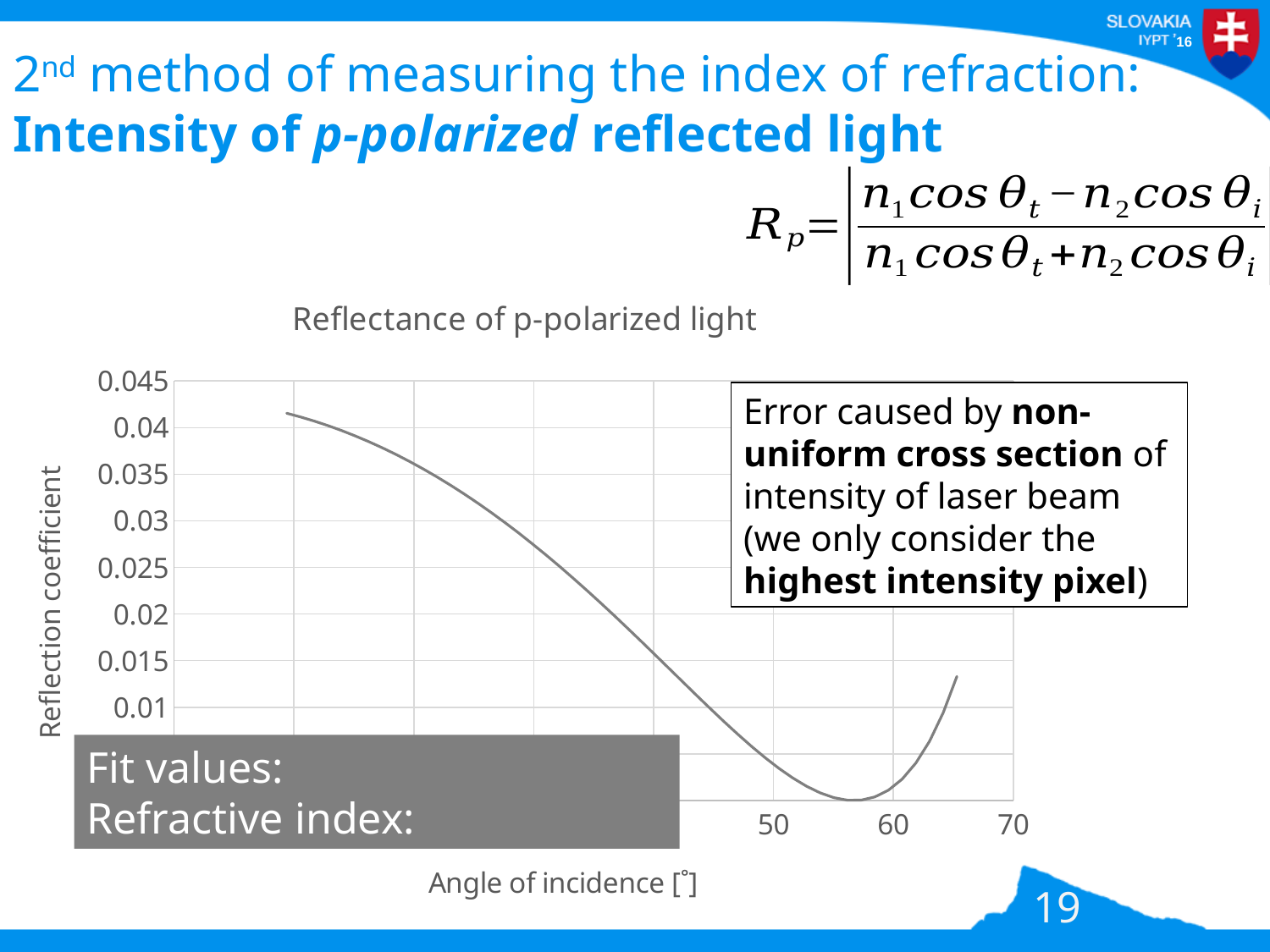
How many lines (series) are plotted on the chart? 1 What is the title of the chart? Reflectance of p-polarized light What is the highest value shown on the y axis of the chart? 0.045 Is the reflection coefficient at an angle of incidence of 60° greater or less than 0.01? less Does the reflection coefficient rise or fall as the angle of incidence increases from 60° to the right end of the curve? rise Does the reflection coefficient rise or fall as the angle of incidence increases from the left end of the curve up to 50°? fall What is the label of the y axis of the chart? Reflection coefficient Is the minimum of the curve located between 50° and 60°, or between 60° and 70°? between 50° and 60° Is the reflection coefficient at an angle of incidence of 50° greater or less than 0.02? less Is the highest reflection coefficient reached by the curve greater or less than 0.035? greater What kind of chart is shown on the slide? line chart